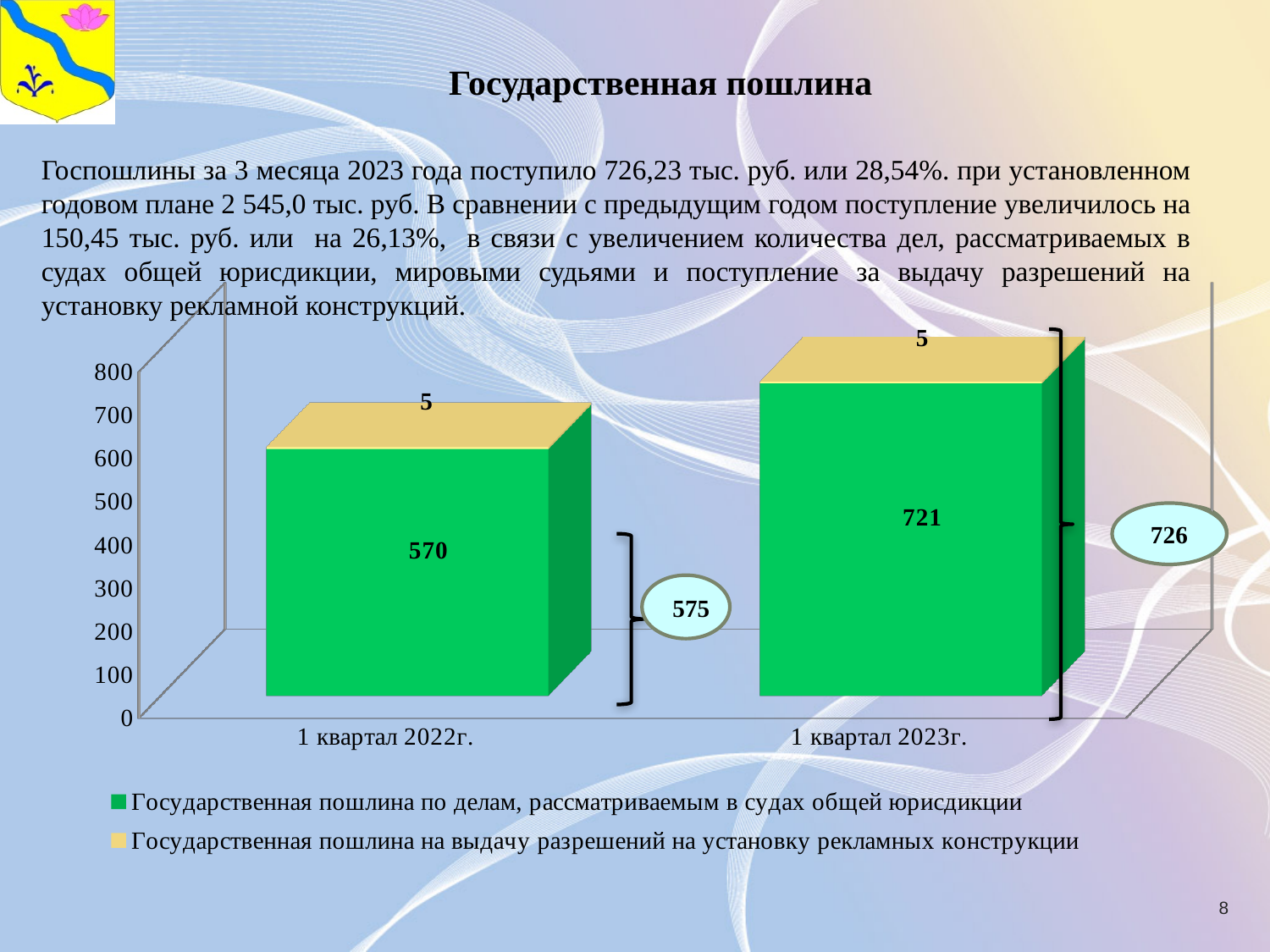
Which category has the higher value for the green series? 1 квартал 2023г. How many categories are shown on the x axis? 2 What is the difference between the stacked bar totals for 1 квартал 2023г. and 1 квартал 2022г.? 151 What is the difference between the green series values for 1 квартал 2023г. and 1 квартал 2022г.? 151 What is the value of the yellow series (Государственная пошлина на выдачу разрешений на установку рекламных конструкции) for 1 квартал 2022г.? 5 Is the green series value for 1 квартал 2022г. greater or less than 600? less What is the total of the stacked bar for 1 квартал 2022г.? 575 What is the total of the stacked bar for 1 квартал 2023г.? 726 How many series does the legend list? 2 What is the value of the green series (Государственная пошлина по делам, рассматриваемым в судах общей юрисдикции) for 1 квартал 2022г.? 570 What kind of chart is shown on the slide? Stacked bar chart What is the value of the green series (Государственная пошлина по делам, рассматриваемым в судах общей юрисдикции) for 1 квартал 2023г.? 721